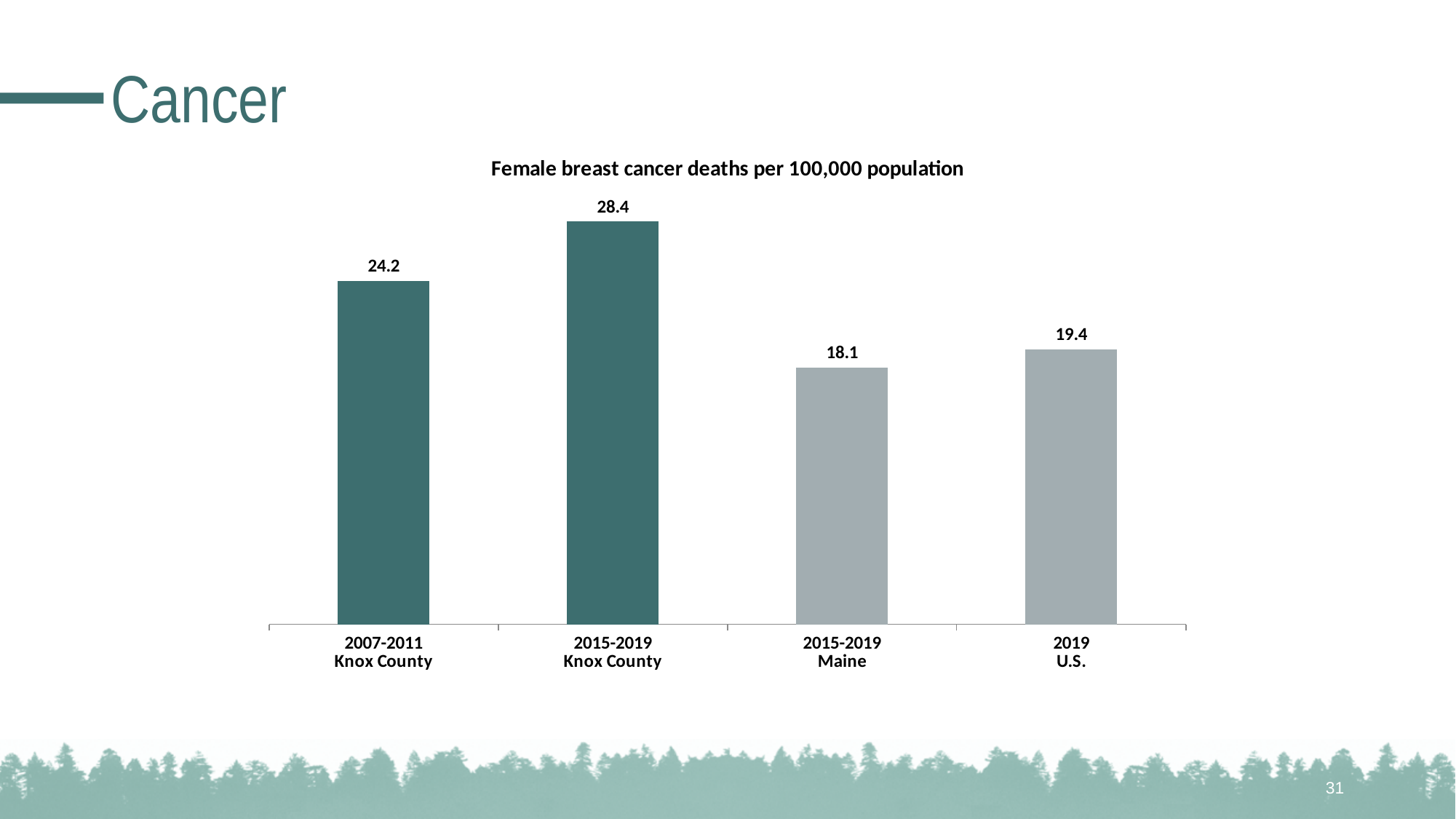
What is the value for 2019 U.S.? 19.4 What is the difference between the 2015-2019 Knox County value and the 2007-2011 Knox County value? 4.2 What is the title of the chart? Female breast cancer deaths per 100,000 population What is the value for 2015-2019 Knox County? 28.4 What is the difference between the 2019 U.S. value and the 2015-2019 Maine value? 1.3 What is the value for 2015-2019 Maine? 18.1 How many categories are shown in the chart? 4 What is the value for 2007-2011 Knox County? 24.2 Which is larger, the value for 2015-2019 Knox County or the value for 2019 U.S.? 2015-2019 Knox County Which category has the lowest value? 2015-2019 Maine Which category has the highest value? 2015-2019 Knox County What kind of chart is shown on the slide? Bar chart